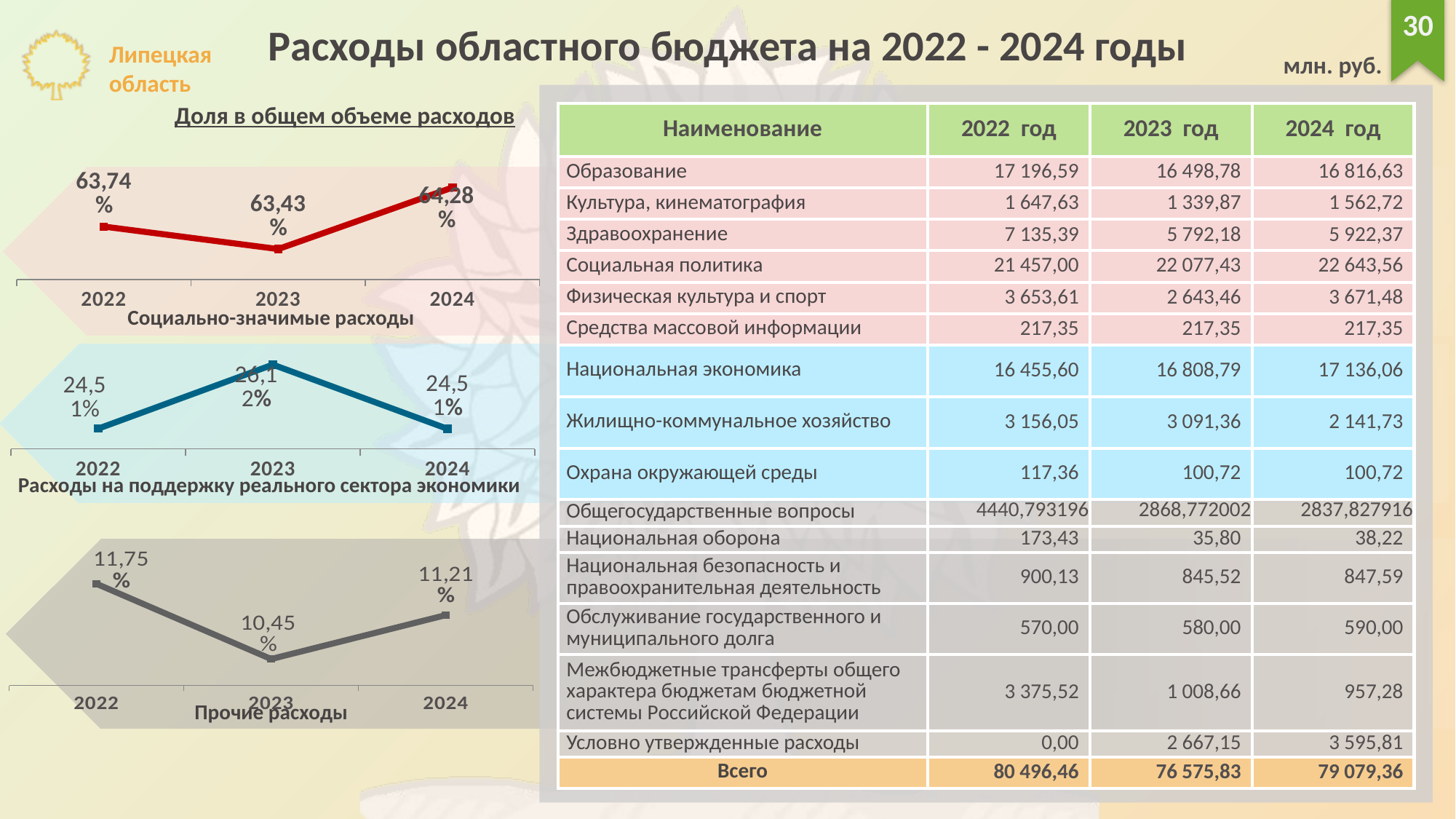
In the chart 'Социально-значимые расходы', which year has the lowest value? 2023 In the chart 'Прочие расходы', what is the value for 2022? 11,75% In the chart 'Расходы на поддержку реального сектора экономики', which year has the highest value? 2023 In the chart 'Прочие расходы', what is the difference between the 2022 and 2023 values? 1,30% In the chart 'Социально-значимые расходы', what is the value for 2022? 63,74% How many data points does the chart 'Социально-значимые расходы' show? 3 In the chart 'Прочие расходы', which is larger, the value for 2022 or the value for 2024? 2022 In the chart 'Расходы на поддержку реального сектора экономики', what is the value for 2023? 26,12% In the chart 'Социально-значимые расходы', which year has the highest value? 2024 In the chart 'Социально-значимые расходы', what is the value for 2023? 63,43% In the chart 'Расходы на поддержку реального сектора экономики', what is the value for 2024? 24,51% In the chart 'Прочие расходы', what is the value for 2023? 10,45%